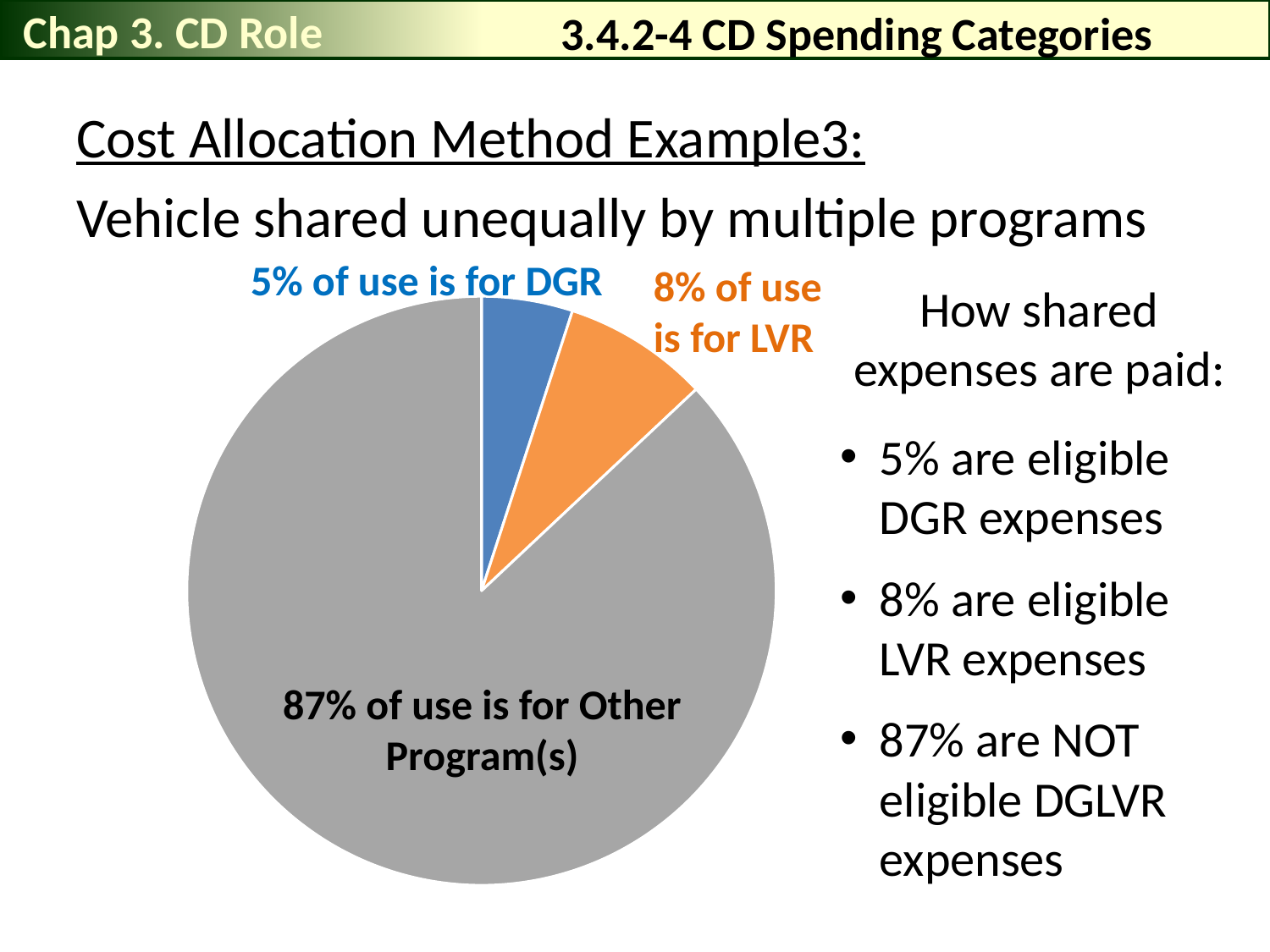
Which slice of the pie is the largest? Other Program(s) Which slice of the pie is the smallest? DGR What is the difference between the share for Other Program(s) and the share for LVR? 79% How many slices does the pie chart have? 3 What is the combined share of use for DGR and LVR? 13% What share of use is for DGR? 5% What colour is the slice for Other Program(s)? gray What kind of chart is shown on the slide? pie chart Which is larger, the share for LVR or the share for DGR? LVR What share of use is for Other Program(s)? 87% What is the difference between the share for LVR and the share for DGR? 3% What share of use is for LVR? 8%